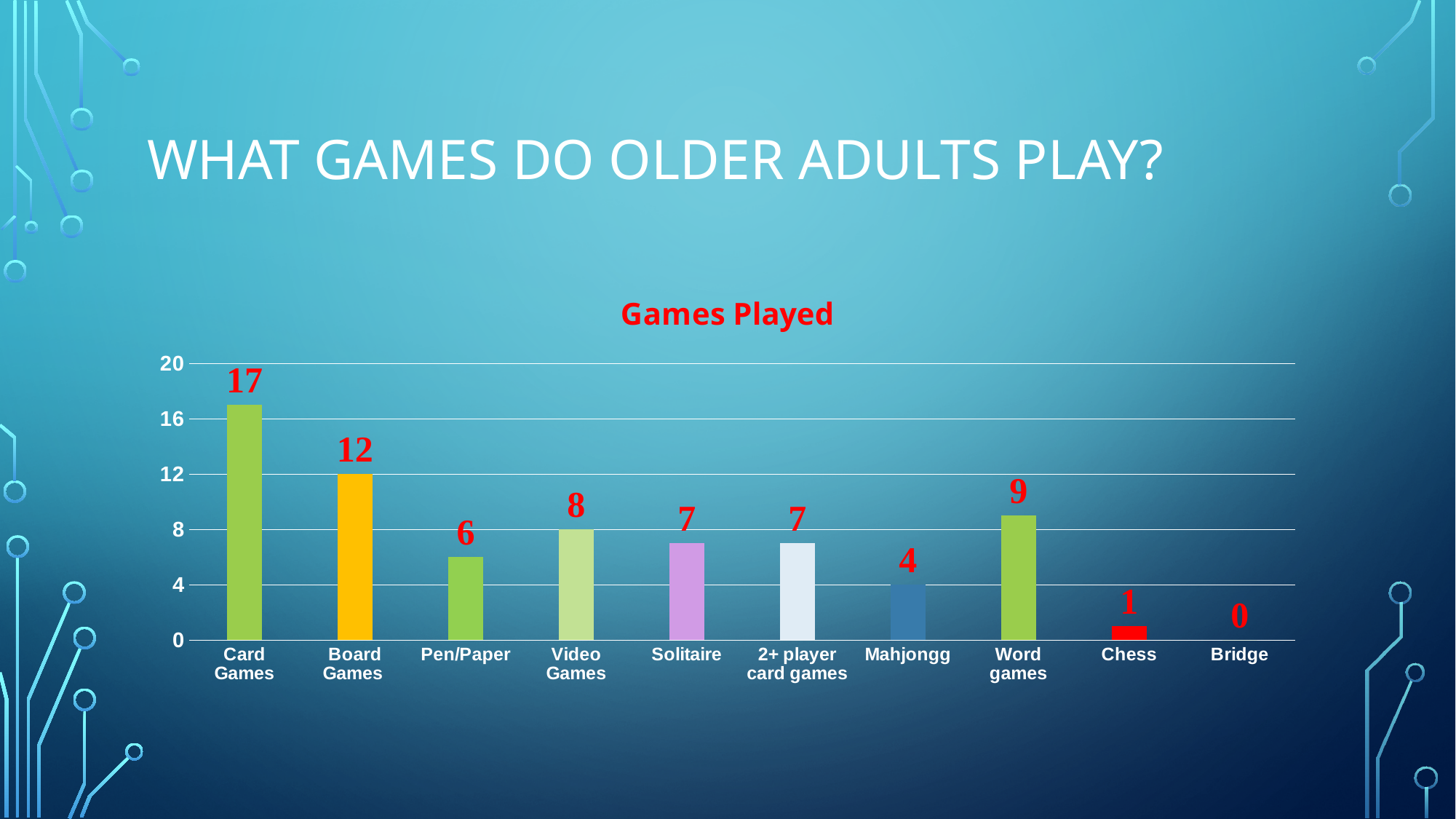
Which is larger, the value for Video Games or the value for Pen/Paper? Video Games What is the value for Word games? 9 What kind of chart is shown? Bar chart What is the value for Mahjongg? 4 What is the value for Chess? 1 How many categories are shown on the x axis? 10 What is the title of the chart? Games Played What is the difference between the values for Word games and Mahjongg? 5 What is the value for Card Games? 17 What is the difference between the values for Card Games and Board Games? 5 Which category has the highest value? Card Games Which category has the lowest value? Bridge